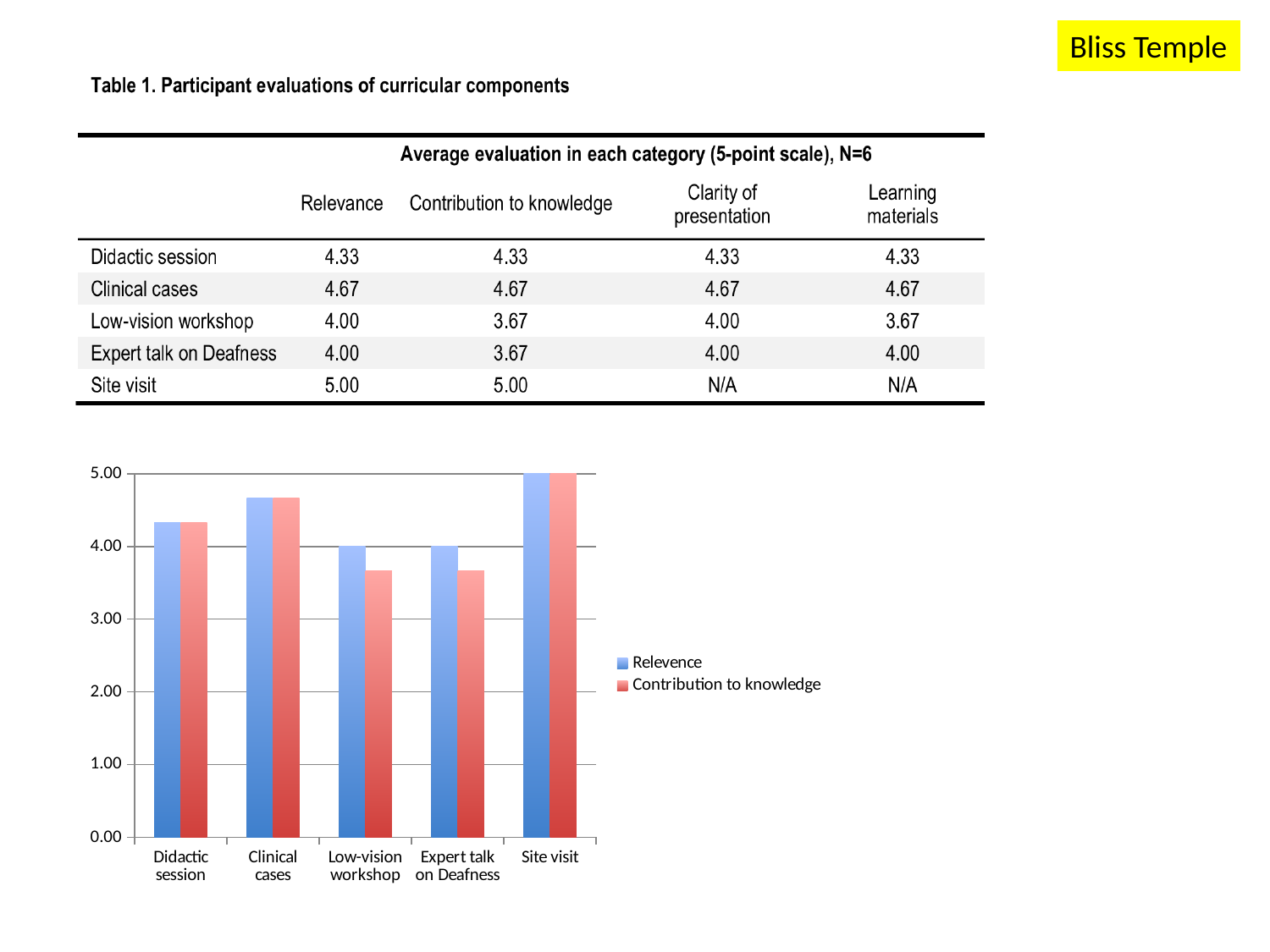
Is the Relevence value for Clinical cases greater or less than 4.00? greater In the chart, which is larger for Low-vision workshop: Relevence or Contribution to knowledge? Relevence What colour are the Contribution to knowledge bars in the chart? red What kind of chart is shown on the slide? bar chart How many series does the chart legend list? 2 What is the Relevence value for Site visit in the chart? 5.00 Which category has the highest Relevence value in the chart? Site visit Which category has the lowest Contribution to knowledge value in the chart? Low-vision workshop and Expert talk on Deafness (tied) Is the Contribution to knowledge value for Expert talk on Deafness greater or less than 4.00? less According to the table, what is the Contribution to knowledge value for Clinical cases? 4.67 What is the Relevence value for Low-vision workshop in the chart? 4.00 How many categories are shown on the x axis of the chart? 5